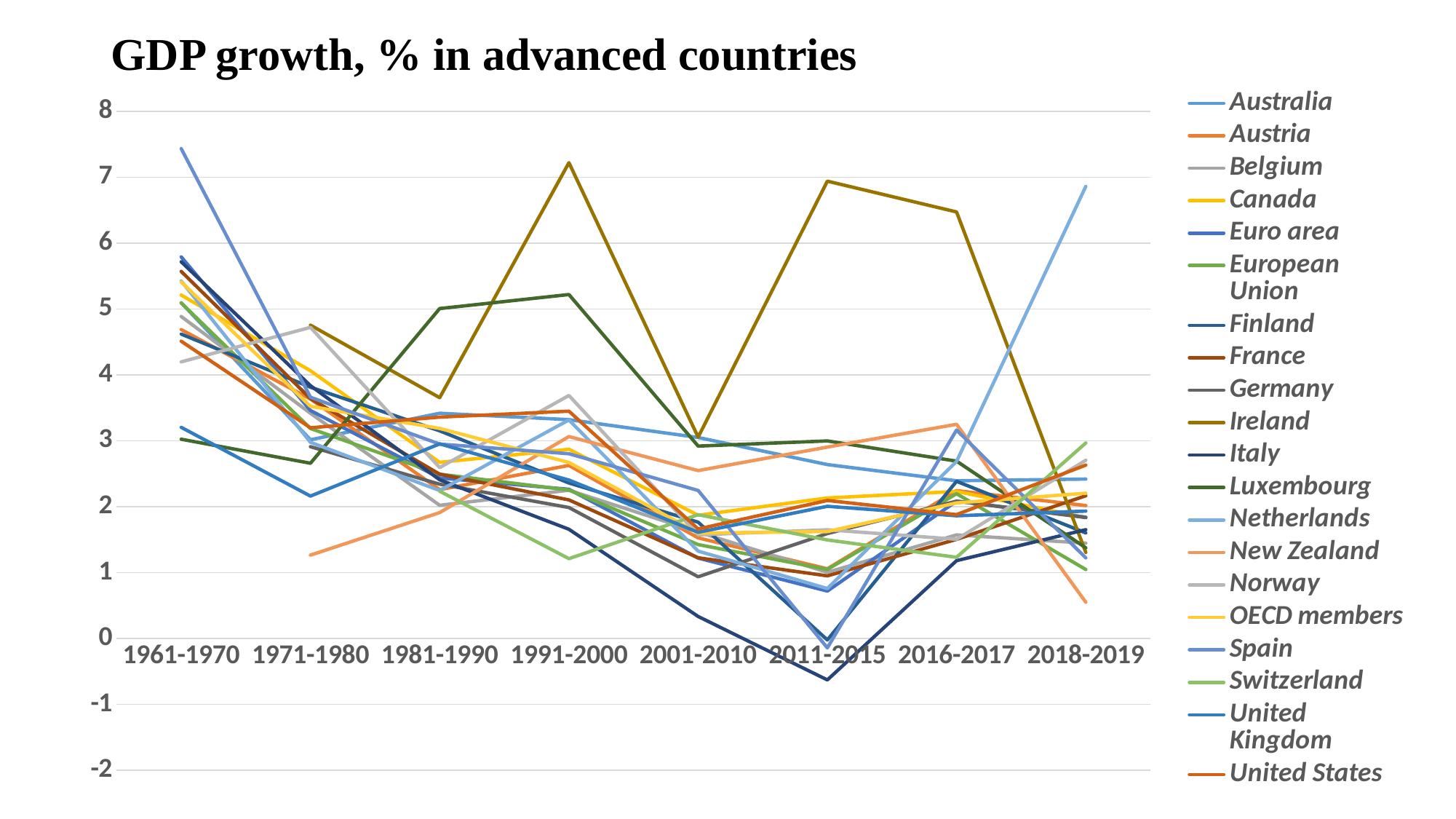
Is the value for Ireland in 2016-2017 greater or less than 6? greater Is the value for New Zealand in 1971-1980 greater or less than 2? less What is the title of the chart? GDP growth, % in advanced countries What type of chart is shown on the slide? Line chart Is the value for New Zealand in 2018-2019 greater or less than 1? less Which period is the last label on the x axis? 2018-2019 How many series does the legend list? 20 How many periods are shown along the x axis? 8